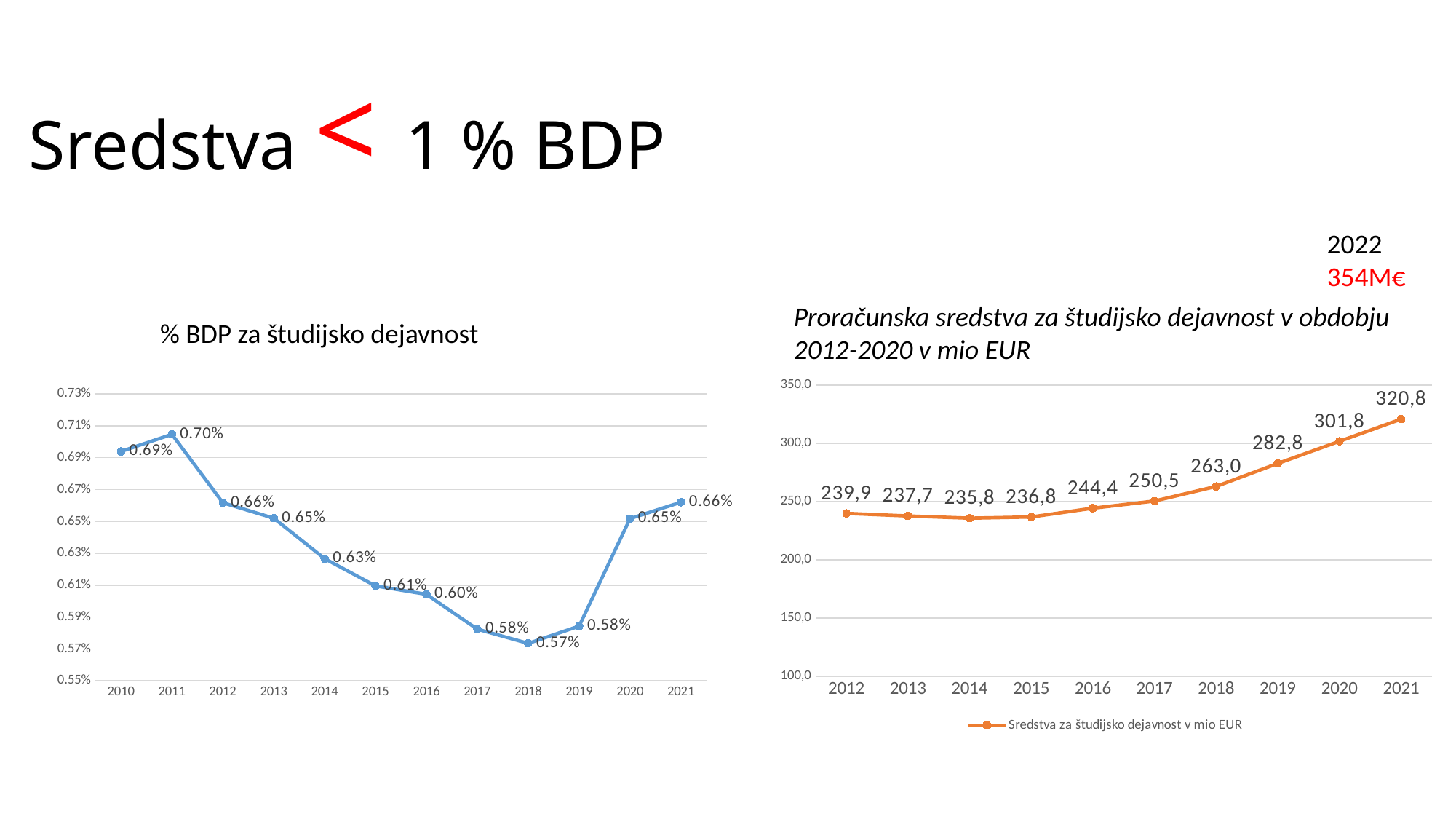
What kind of chart is the chart on the right (Proračunska sredstva za študijsko dejavnost)? line chart In the chart titled '% BDP za študijsko dejavnost', which year has the lowest value? 2018 In the chart on the right, what series name does the legend show? Sredstva za študijsko dejavnost v mio EUR In the chart titled '% BDP za študijsko dejavnost', what is the value for 2014? 0.63% In the chart titled '% BDP za študijsko dejavnost', what is the value for 2018? 0.57% In the chart titled '% BDP za študijsko dejavnost', which year has the highest value? 2011 In the chart on the right (Proračunska sredstva za študijsko dejavnost), do the values rise or fall from 2015 to 2021? rise In the chart on the right (Proračunska sredstva za študijsko dejavnost), what is the value for 2019? 282,8 In the chart on the right (Proračunska sredstva za študijsko dejavnost), which year has the lowest value? 2014 In the chart on the right (Proračunska sredstva za študijsko dejavnost), what is the difference between the values for 2021 and 2020? 19,0 In the chart titled '% BDP za študijsko dejavnost', how many years are plotted? 12 In the chart on the right (Proračunska sredstva za študijsko dejavnost), is the value for 2021 greater or less than 300,0? greater